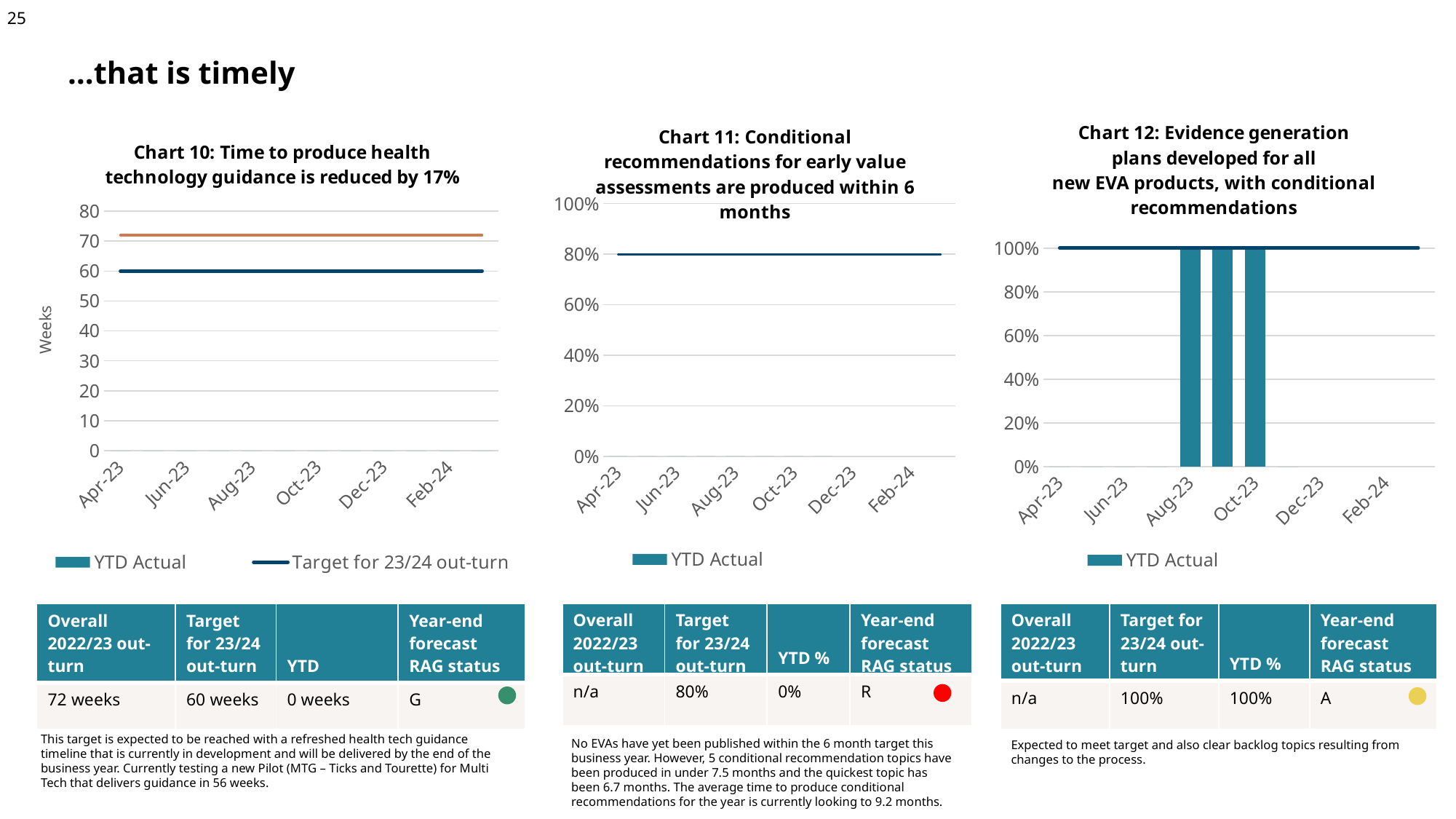
What is the label on the vertical axis of Chart 10? Weeks In Chart 11, at what value does the plotted line sit? 80% In Chart 10, which line is higher, the orange line or the dark blue line? the orange line How many series does the legend of Chart 11 list? 1 In Chart 12, what value do the bars reach? 100% In Chart 12, how many bars are plotted? 3 What kind of chart is Chart 10: Time to produce health technology guidance is reduced by 17%? line chart What is the legend entry shown under Chart 12? YTD Actual In Chart 11, does the plotted line rise, fall or stay flat from Apr-23 to Feb-24? stay flat How many series does the legend of Chart 10 list? 2 In Chart 10, what value does the dark blue 'Target for 23/24 out-turn' line sit at? 60 In Chart 10, is the orange line greater or less than 70? greater